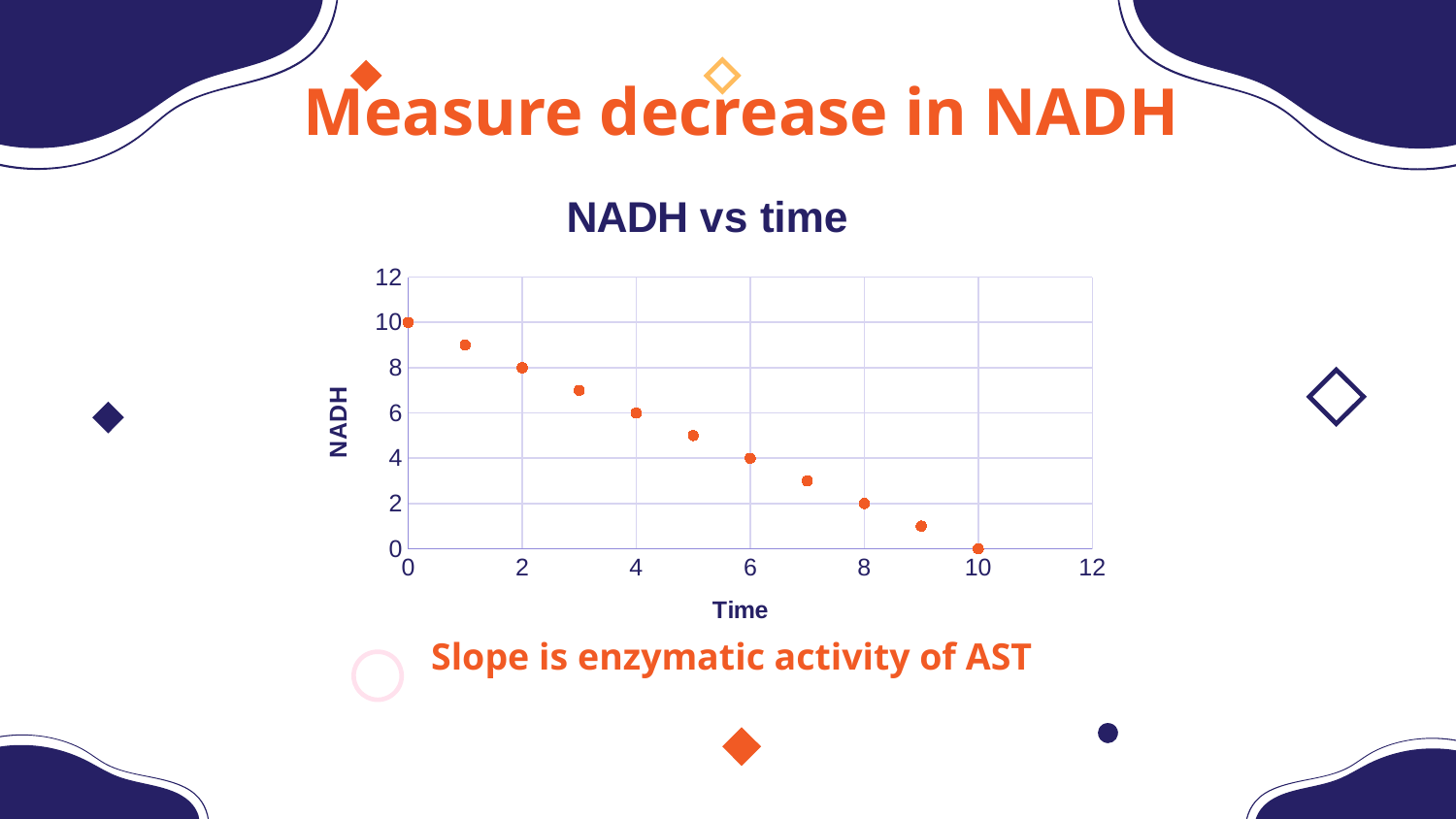
Do the NADH values rise or fall as time increases? fall What is the title of the chart? NADH vs time What is the NADH value at time 0? 10 What kind of chart is shown on the slide? scatter plot Is the NADH value at time 1 greater or less than 8? greater What is the difference between the NADH value at time 0 and at time 10? 10 Which is larger, the NADH value at time 2 or at time 8? time 2 What is the NADH value at time 4? 6 At which time is the NADH value lowest? 10 How many data points are plotted on the chart? 11 At which time is the NADH value highest? 0 What is the NADH value at time 10? 0